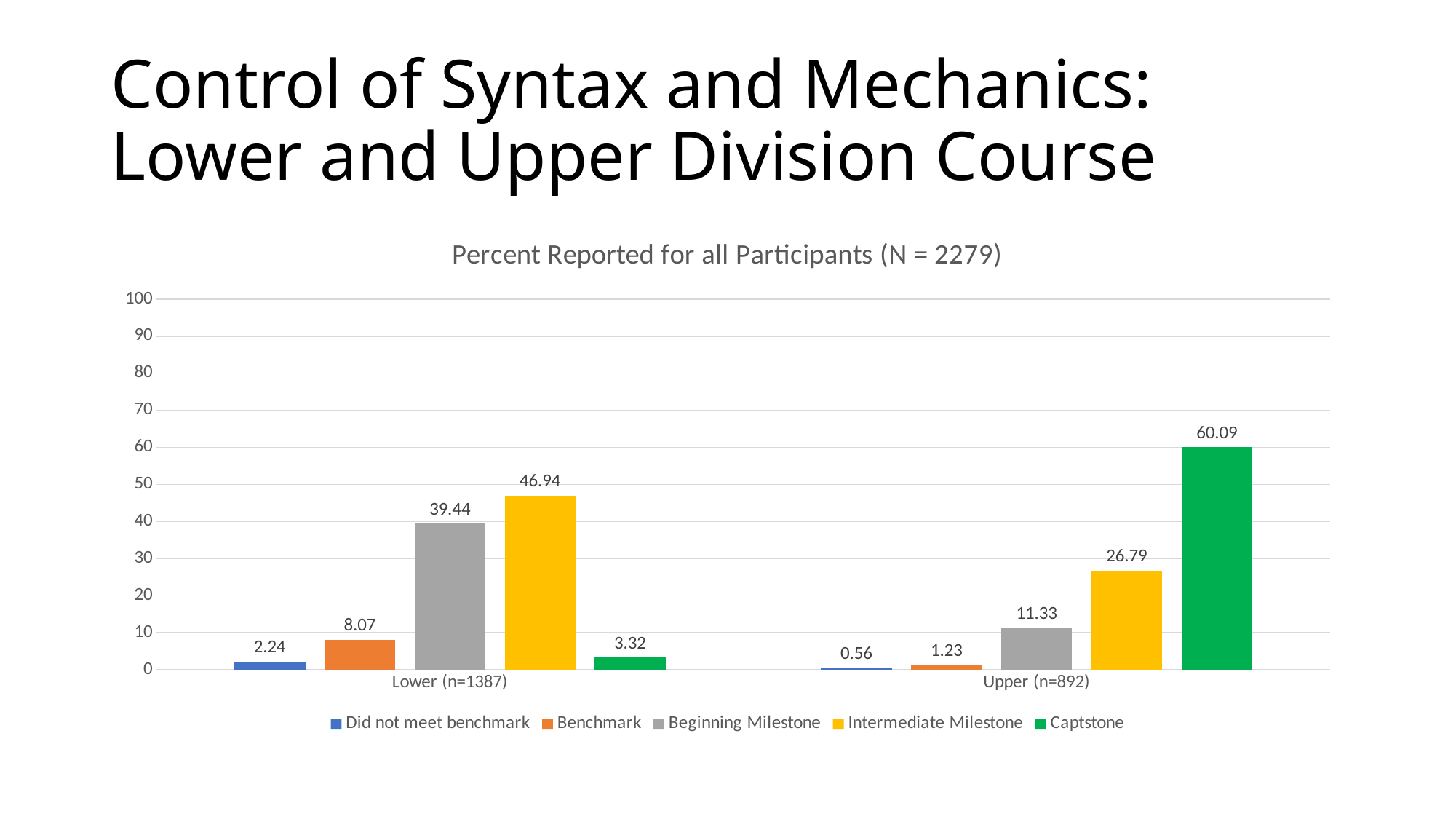
Which series has the lowest value in the Upper (n=892) group? Did not meet benchmark What is the difference between the Captstone values for Upper (n=892) and Lower (n=1387)? 56.77 How many series does the legend list? 5 What is the value for Captstone in the Upper (n=892) group? 60.09 Is the value for Intermediate Milestone in the Upper (n=892) group greater or less than 30? less Which is larger: Beginning Milestone for Lower (n=1387) or Beginning Milestone for Upper (n=892)? Lower (n=1387) What is the value for Did not meet benchmark in the Upper (n=892) group? 0.56 What is the title of the chart? Percent Reported for all Participants (N = 2279) Which series has the highest value in the Lower (n=1387) group? Intermediate Milestone What is the value for Intermediate Milestone in the Lower (n=1387) group? 46.94 How many categories are shown on the x axis? 2 What kind of chart is shown on the slide? bar chart